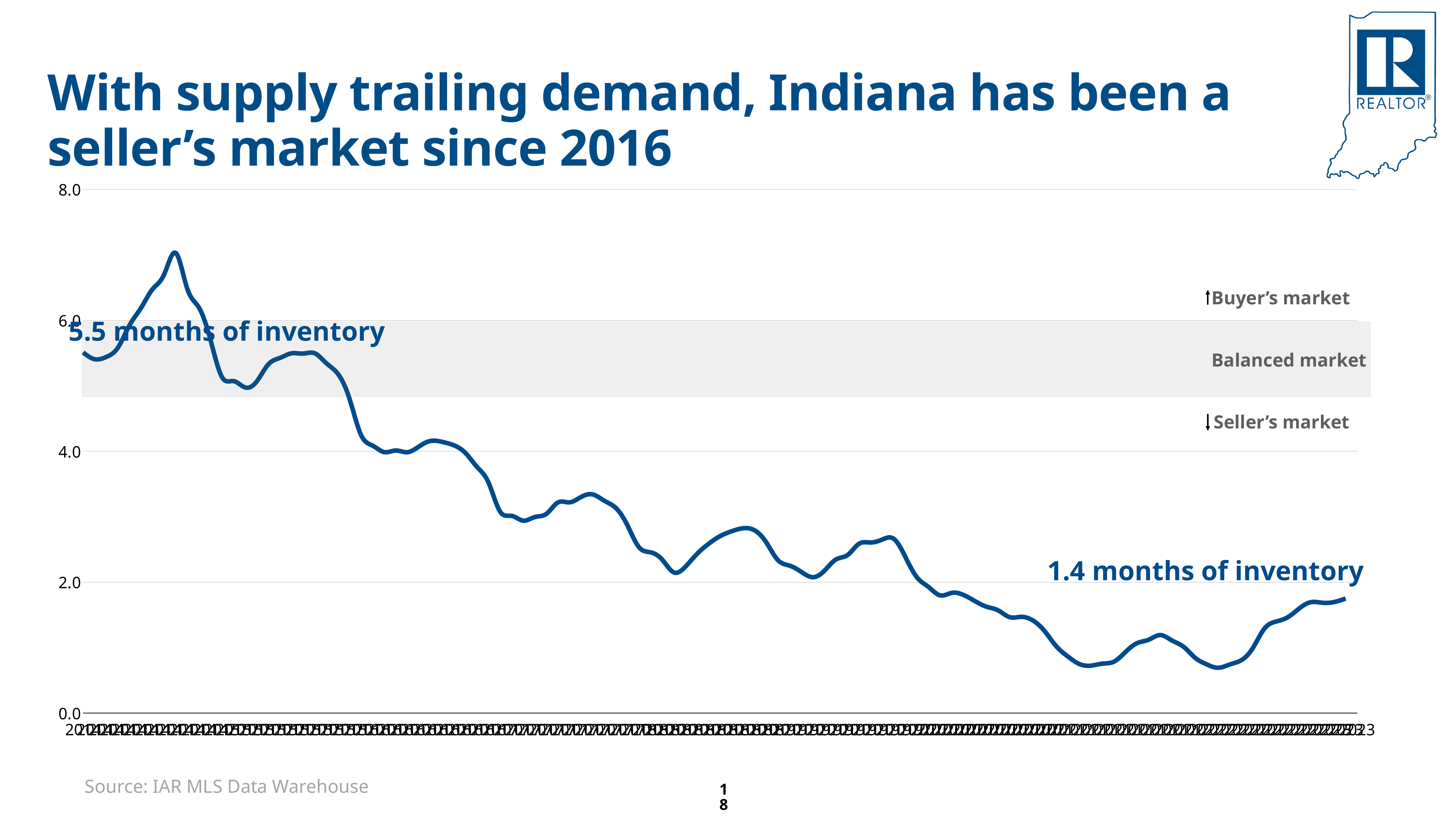
What kind of chart is shown on the slide? line chart What label is given to the shaded band on the chart? Balanced market Which is larger: the annotated months of inventory at the start of the series or at the end? start (5.5 months) Overall, do the months of inventory rise or fall from left to right along the x axis? fall By how many months did inventory fall from the annotated start value (5.5 months) to the annotated end value (1.4 months)? 4.1 months What is the highest value shown on the y axis? 8.0 Is the highest point of the line greater or less than 6.0? greater Is the value at the end of the line greater or less than 2.0? less According to the annotation, how many months of inventory did Indiana have at the end of the series? 1.4 months According to the annotation, how many months of inventory did Indiana have at the start of the series? 5.5 months Is the lowest point of the line greater or less than 2.0? less